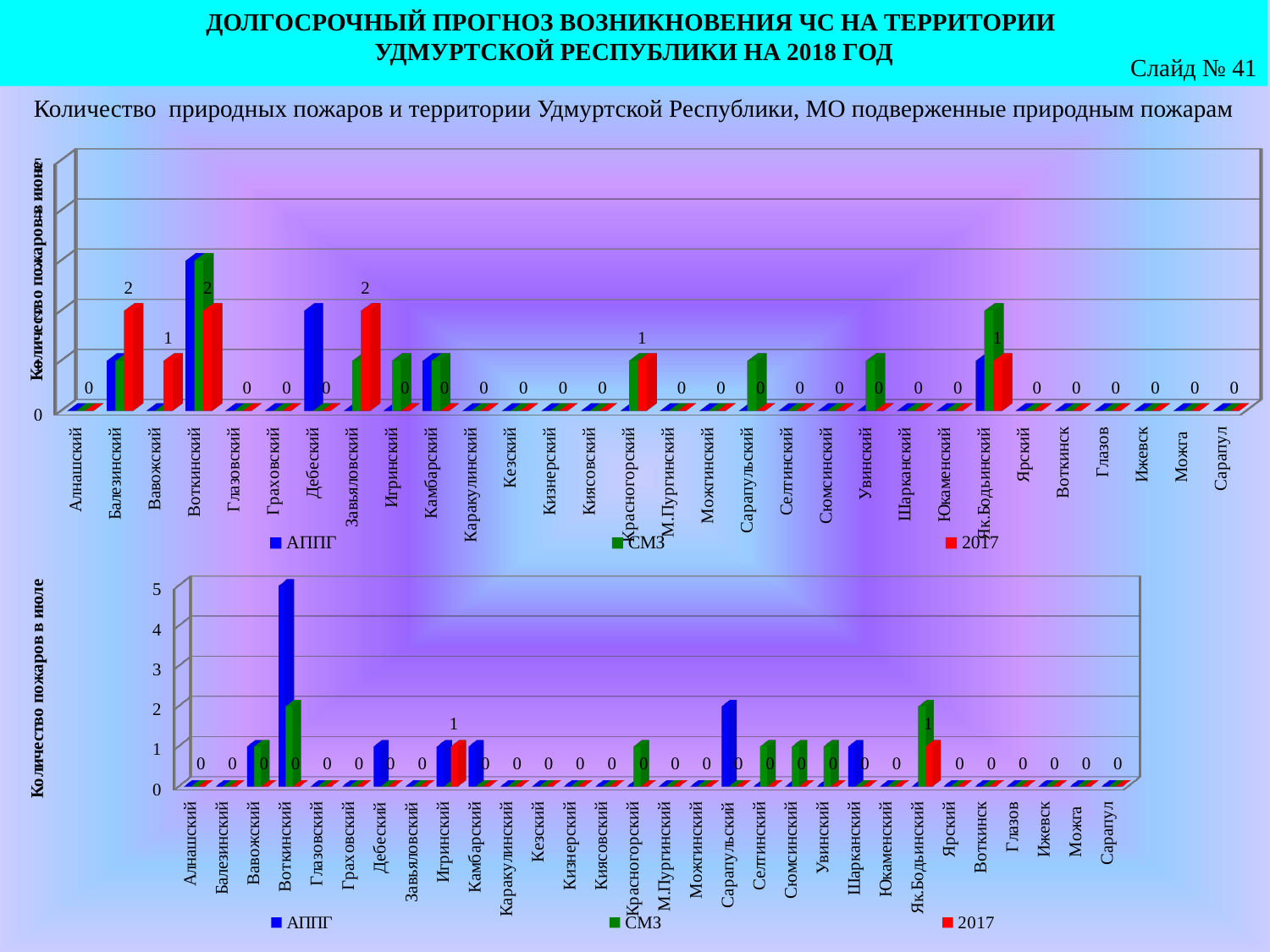
In the top chart (Количество пожаров в июне), what is the 2017 value for Вавожский? 1 In the top chart (Количество пожаров в июне), what is the difference between the 2017 values for Балезинский and Вавожский? 1 What kind of chart is the top chart (Количество пожаров в июне)? bar chart In the bottom chart (Количество пожаров в июле), which category has the highest АППГ value? Воткинский In the top chart (Количество пожаров в июне), which is larger for 2017: Балезинский or Вавожский? Балезинский In the top chart (Количество пожаров в июне), what is the 2017 value for Балезинский? 2 In the bottom chart (Количество пожаров в июле), what is the 2017 value for Игринский? 1 How many series does the legend of the bottom chart (Количество пожаров в июле) list? 3 In the top chart (Количество пожаров в июне), what is the 2017 value for Завьяловский? 2 In the bottom chart (Количество пожаров в июле), what is the 2017 value for Як.Бодьинский? 1 In the bottom chart (Количество пожаров в июле), what is the АППГ value for Воткинский? 5 What are the legend entries of the top chart (Количество пожаров в июне)? АППГ, СМЗ, 2017